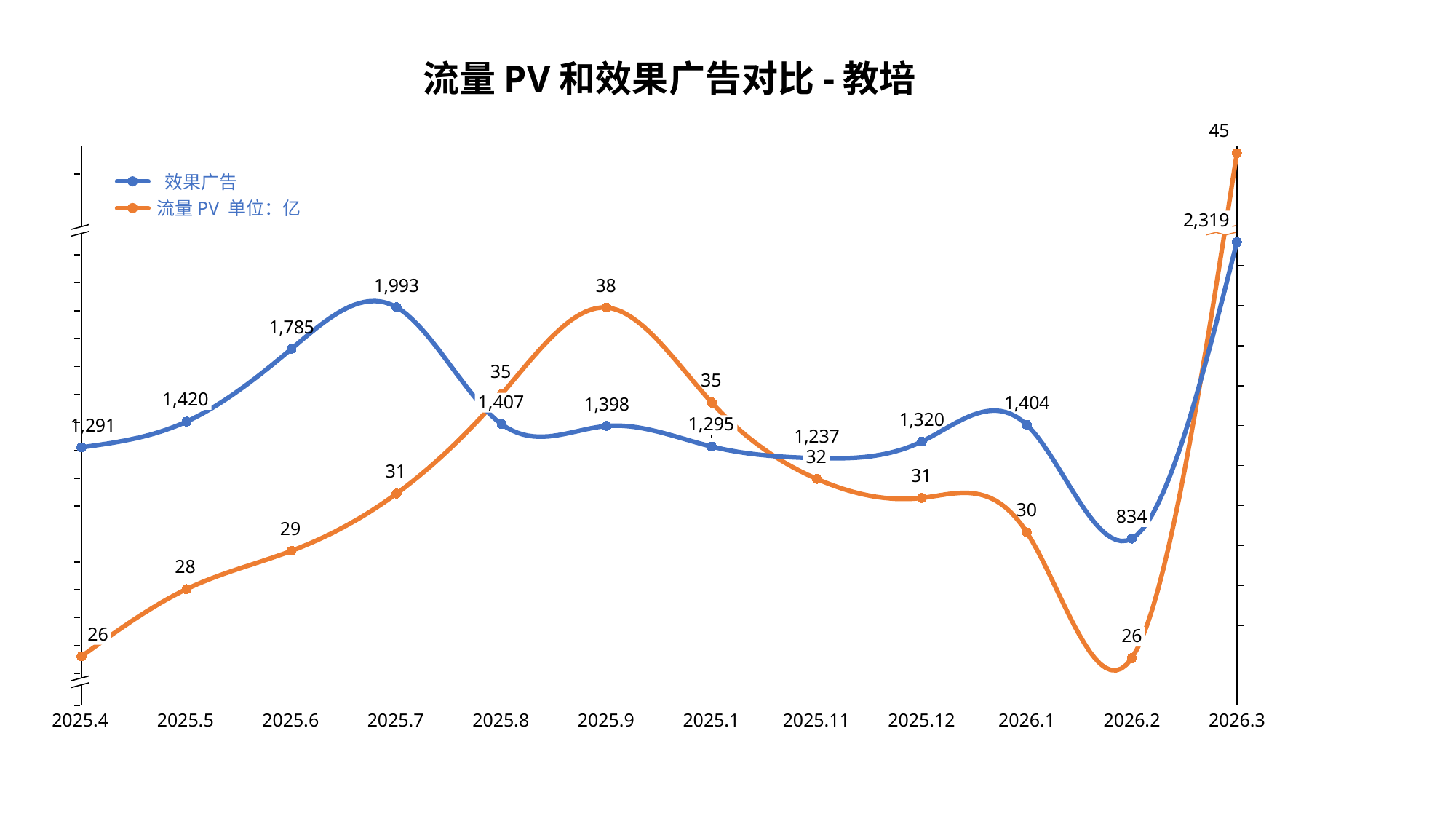
What is the value of 效果广告 at 2025.7? 1,993 What is the value of 效果广告 at 2026.2? 834 Which is larger for 流量 PV: the value at 2025.8 or the value at 2025.11? 2025.8 At which x-axis point is 效果广告 lowest? 2026.2 What is the value of 流量 PV at 2025.9? 38 At which x-axis point is 流量 PV highest? 2026.3 What is the title of the chart? 流量 PV 和效果广告对比 - 教培 What is the difference between the 效果广告 values at 2026.3 and 2026.2? 1,485 How many series does the legend list? 2 How many points are plotted along the x axis for each series? 12 At which x-axis point is 效果广告 highest? 2026.3 What type of chart is shown on the slide? line chart